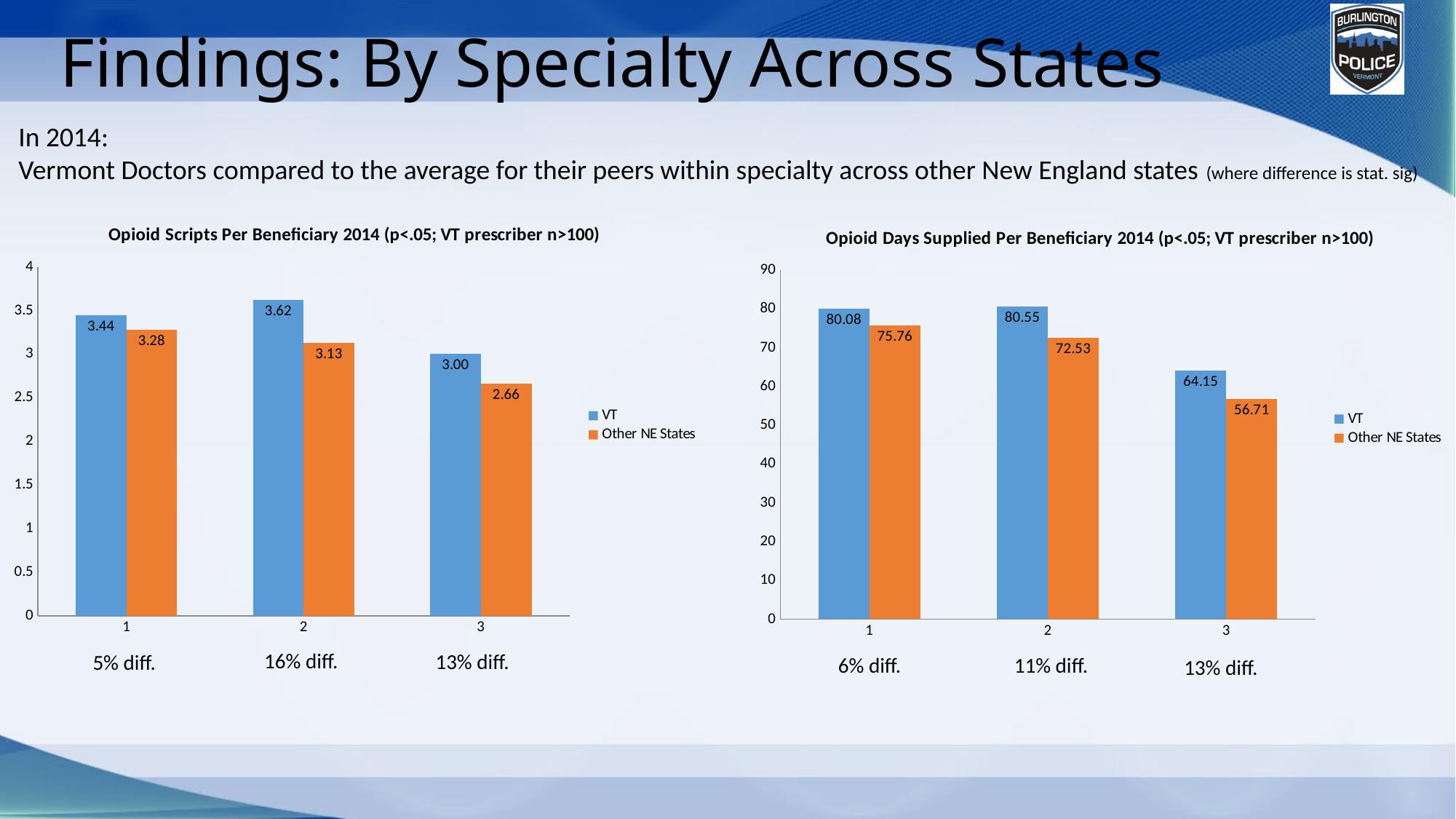
In the 'Opioid Scripts Per Beneficiary 2014' chart, what is the VT value for category 2? 3.62 In the 'Opioid Scripts Per Beneficiary 2014' chart, what is the difference between the VT and Other NE States values for category 2? 0.49 In the 'Opioid Days Supplied Per Beneficiary 2014' chart, which category has the lowest Other NE States value? 3 In the 'Opioid Scripts Per Beneficiary 2014' chart, what is the Other NE States value for category 3? 2.66 In the 'Opioid Days Supplied Per Beneficiary 2014' chart, which is larger for category 1: VT or Other NE States? VT What kind of chart is the 'Opioid Days Supplied Per Beneficiary 2014' chart? Bar chart In the 'Opioid Days Supplied Per Beneficiary 2014' chart, what is the VT value for category 1? 80.08 In the 'Opioid Days Supplied Per Beneficiary 2014' chart, what is the Other NE States value for category 2? 72.53 In the 'Opioid Days Supplied Per Beneficiary 2014' chart, what colour are the Other NE States bars? Orange In the 'Opioid Scripts Per Beneficiary 2014' chart, which category has the highest VT value? 2 In the 'Opioid Days Supplied Per Beneficiary 2014' chart, what is the difference between the VT and Other NE States values for category 3? 7.44 How many series does the legend list in the 'Opioid Scripts Per Beneficiary 2014' chart? 2